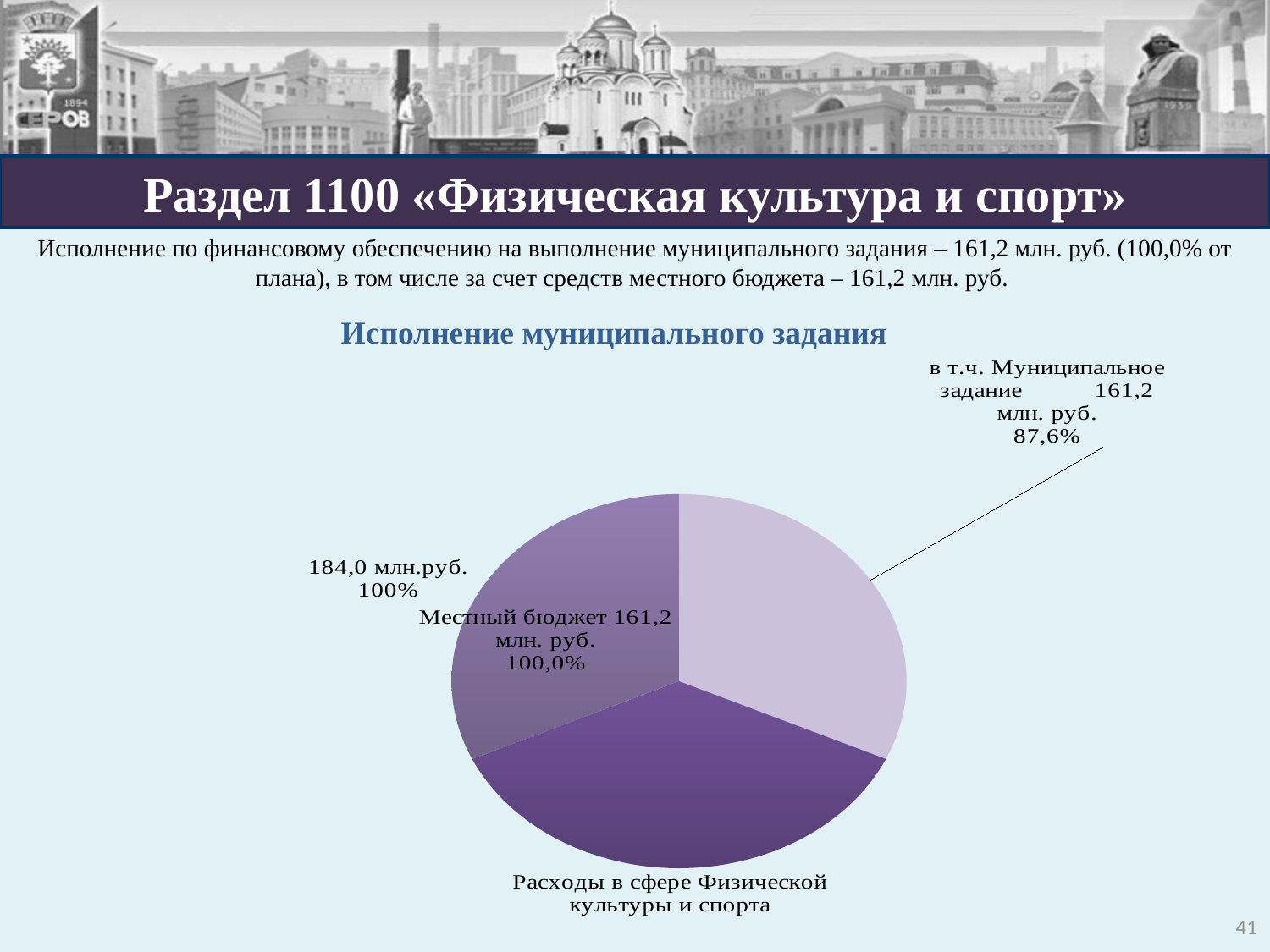
What value is shown for «Местный бюджет» in the pie chart? 161,2 млн. руб. What percentage is printed next to «Местный бюджет» in the pie chart? 100,0% Which slice of the pie chart has the largest value in млн. руб.? Расходы в сфере Физической культуры и спорта What is the title of the pie chart on the slide? Исполнение муниципального задания What value is shown for «в т.ч. Муниципальное задание» in the pie chart? 161,2 млн. руб. What percentage is printed next to «Расходы в сфере Физической культуры и спорта» in the pie chart? 100% What value is shown for «Расходы в сфере Физической культуры и спорта» in the pie chart? 184,0 млн.руб. How many slices does the pie chart «Исполнение муниципального задания» have? 3 What kind of chart is shown under the title «Исполнение муниципального задания»? Pie chart Which is larger in the pie chart: the value for «Расходы в сфере Физической культуры и спорта» or the value for «Местный бюджет»? Расходы в сфере Физической культуры и спорта What percentage is printed next to «в т.ч. Муниципальное задание» in the pie chart? 87,6% By how much does the value for «Расходы в сфере Физической культуры и спорта» exceed the value for «Местный бюджет» in the pie chart? 22,8 млн. руб.